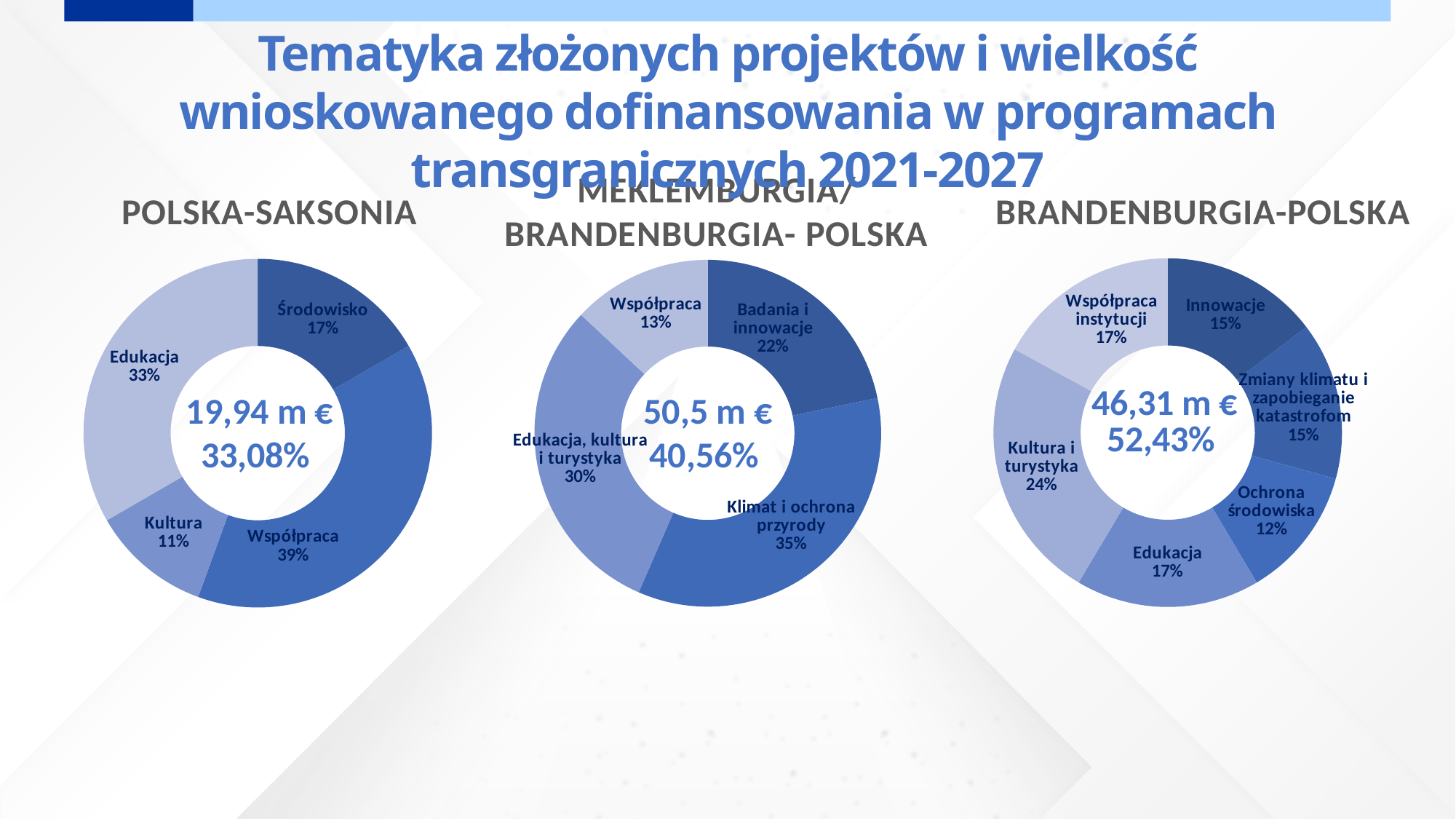
In the BRANDENBURGIA-POLSKA chart, what share does Kultura i turystyka have? 24% What amount is shown in the centre of the MEKLEMBURGIA/BRANDENBURGIA-POLSKA chart? 50,5 m € How many categories are shown in the BRANDENBURGIA-POLSKA chart? 6 In the BRANDENBURGIA-POLSKA chart, which category has the smallest share? Ochrona środowiska In the POLSKA-SAKSONIA chart, what is the difference in percentage points between Edukacja and Środowisko? 16 What type of chart is used for the three programmes on the slide? Pie (doughnut) chart In the POLSKA-SAKSONIA chart, which category has the smallest share? Kultura In the POLSKA-SAKSONIA chart, what share does Współpraca have? 39% In the MEKLEMBURGIA/BRANDENBURGIA-POLSKA chart, which category has the largest share? Klimat i ochrona przyrody In the MEKLEMBURGIA/BRANDENBURGIA-POLSKA chart, what share does Klimat i ochrona przyrody have? 35% In the MEKLEMBURGIA/BRANDENBURGIA-POLSKA chart, which is larger: Badania i innowacje or Współpraca? Badania i innowacje How many categories are shown in the POLSKA-SAKSONIA chart? 4